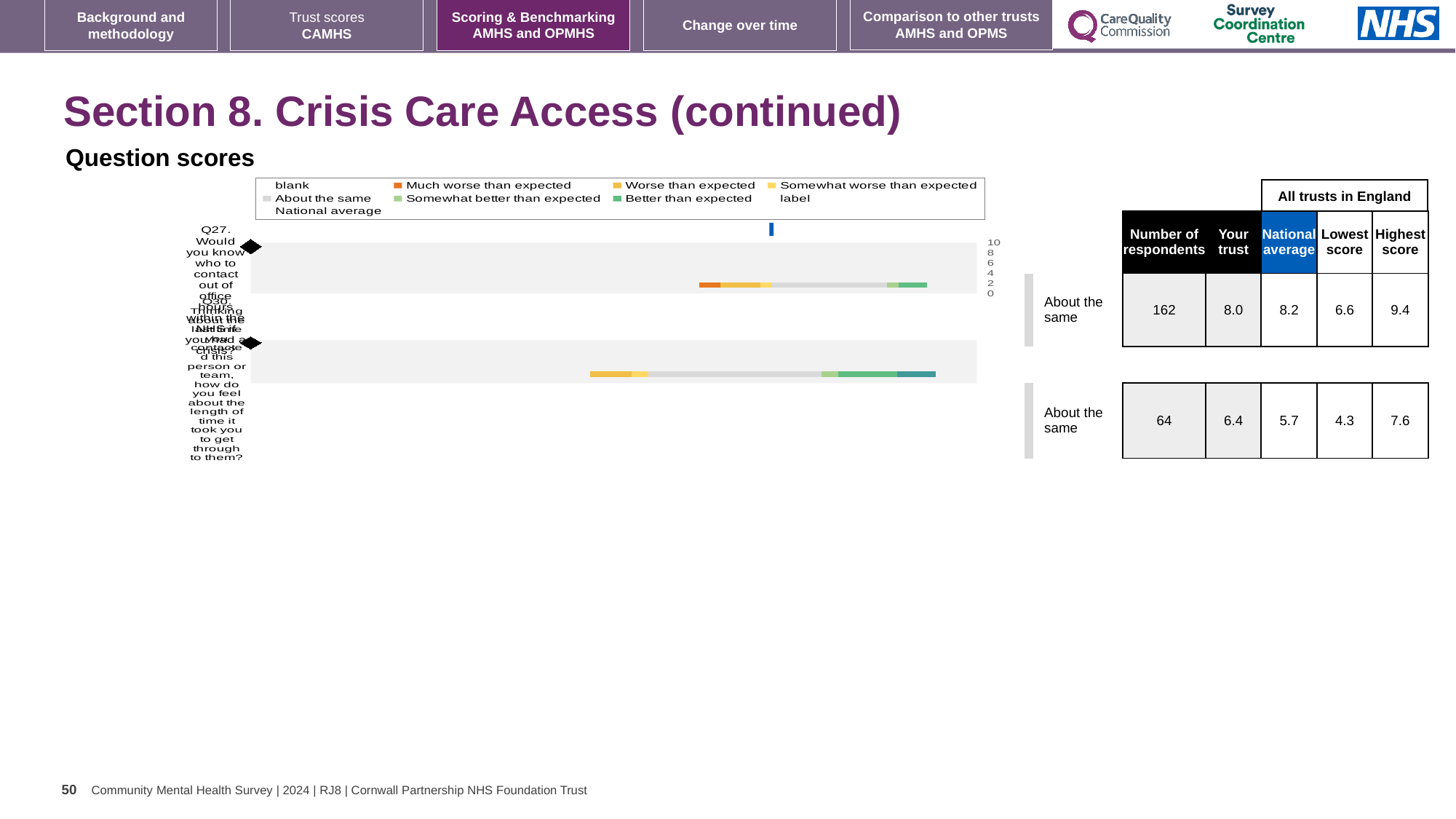
What is the national average score for Q27? 8.2 Which question has the higher 'Your trust' score, Q27 or Q30? Q27 What is the 'Your trust' score for Q30 (how do you feel about the length of time it took you to get through to them)? 6.4 What is the number of respondents for Q27 (Would you know who to contact out of office hours)? 162 What category label is shown for both Q27 and Q30 next to the chart? About the same What is the difference between the highest score and the lowest score for Q30? 3.3 What is the 'Your trust' score for Q27? 8.0 What kind of chart is used to show the question scores on this slide? bar chart What is the highest score among all trusts in England for Q27? 9.4 What is the lowest score among all trusts in England for Q30? 4.3 Which is larger for Q30, the 'Your trust' score or the national average? Your trust How many survey questions are plotted in the question scores chart? 2